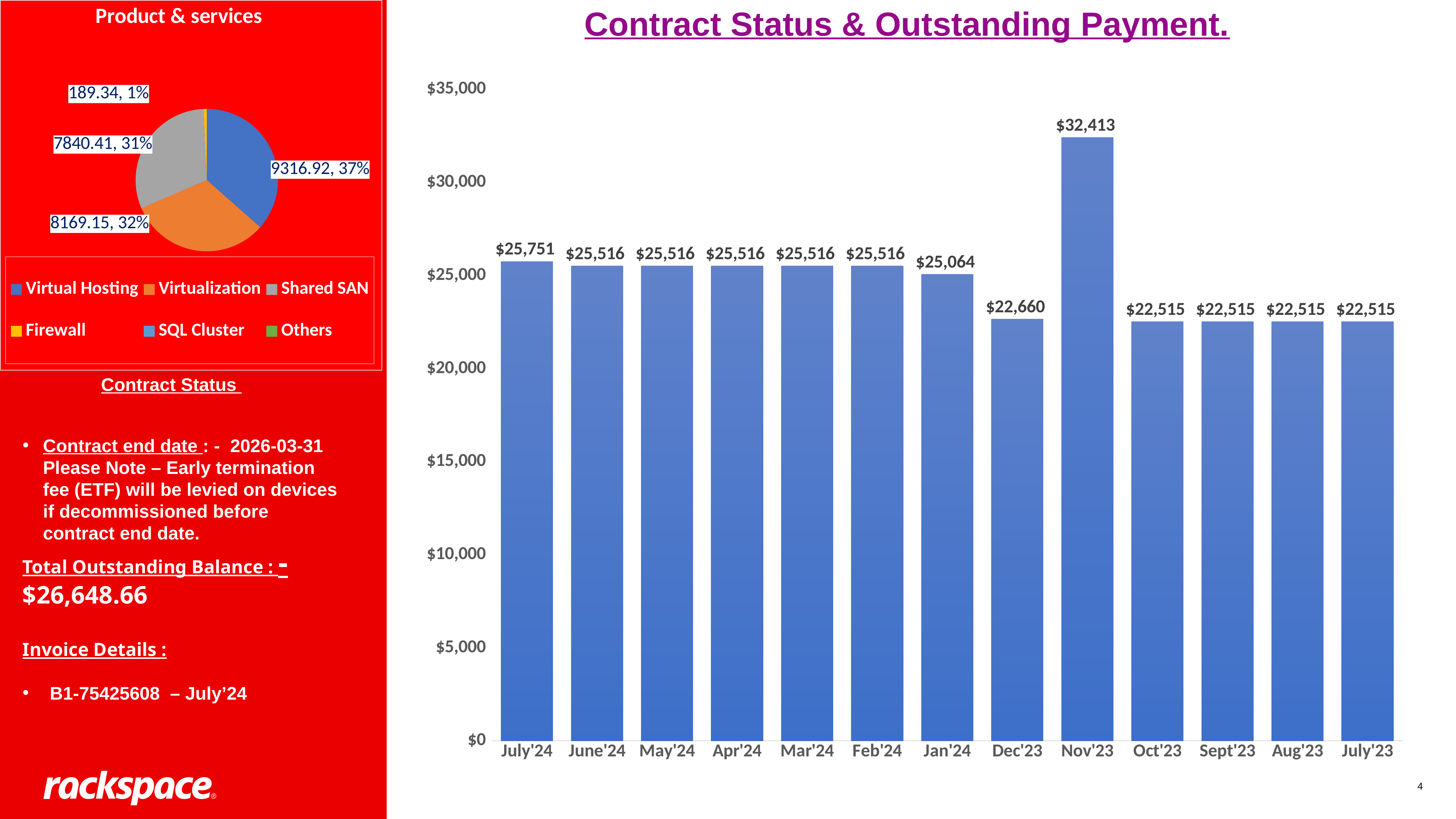
In the Product & services pie chart, what is the value shown for the Virtualization slice? 8169.15 In the Contract Status & Outstanding Payment chart, what is the value for July'24? $25,751 How many entries does the legend of the Product & services pie chart list? 6 In the Contract Status & Outstanding Payment chart, what is the difference between the values for Nov'23 and Dec'23? $9,753 In the Contract Status & Outstanding Payment chart, what is the value for Nov'23? $32,413 What kind of chart is the Contract Status & Outstanding Payment chart? bar chart In the Product & services pie chart, which slice is the smallest? Firewall In the Product & services pie chart, what share does the Virtual Hosting slice have? 37% How many months are shown on the x axis of the Contract Status & Outstanding Payment chart? 13 In the Contract Status & Outstanding Payment chart, is the value for Oct'23 greater or less than $25,000? less In the Contract Status & Outstanding Payment chart, which is larger, the value for Jan'24 or the value for Dec'23? Jan'24 In the Contract Status & Outstanding Payment chart, which month has the highest value? Nov'23